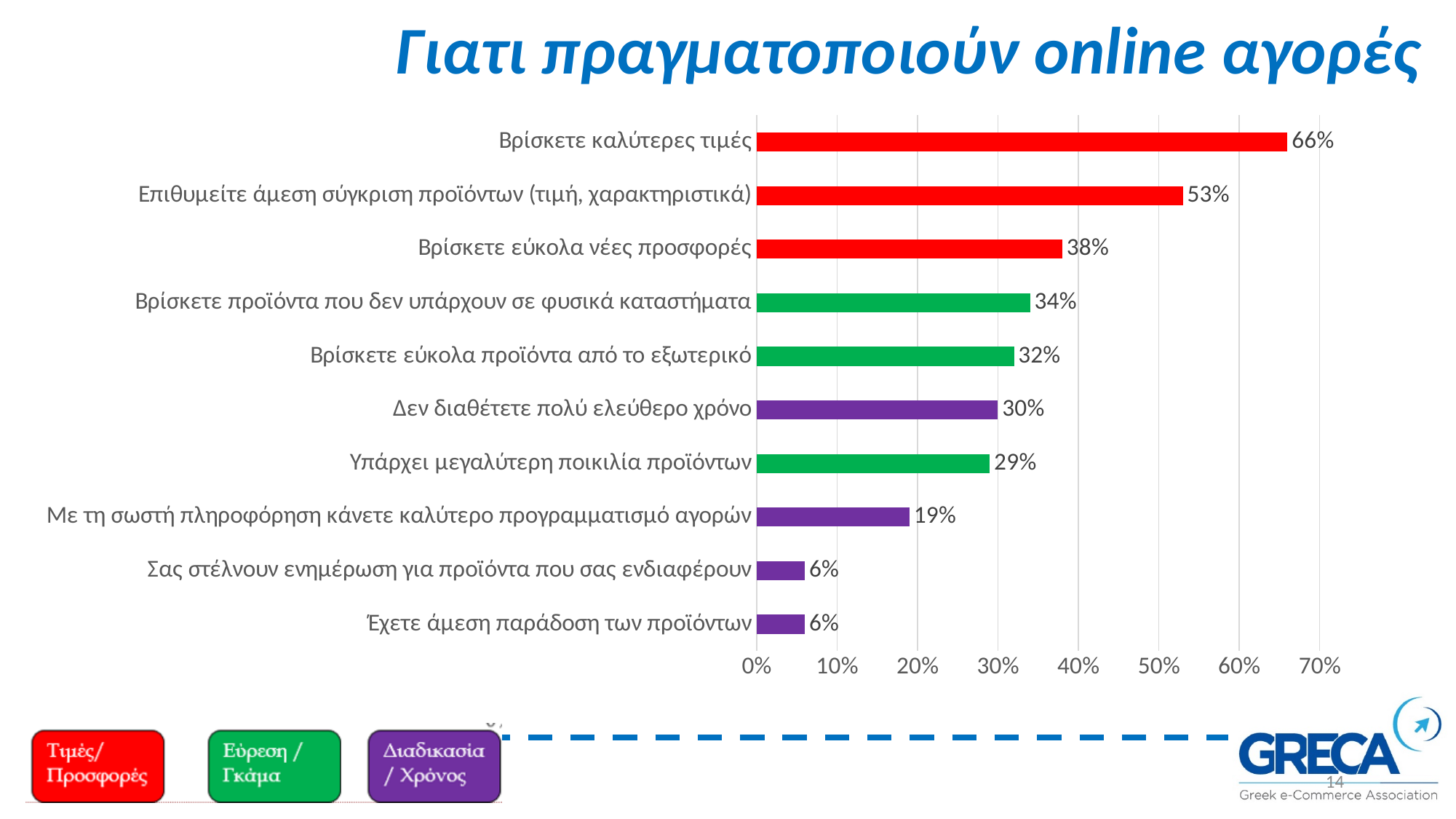
What is the difference between "Βρίσκετε εύκολα προϊόντα από το εξωτερικό" and "Υπάρχει μεγαλύτερη ποικιλία προϊόντων"? 3% What is the difference between "Βρίσκετε καλύτερες τιμές" and "Επιθυμείτε άμεση σύγκριση προϊόντων (τιμή, χαρακτηριστικά)"? 13% What colour are the bars for the "Τιμές/Προσφορές" group? red What is the value for "Δεν διαθέτετε πολύ ελεύθερο χρόνο"? 30% What percentage is shown for "Βρίσκετε καλύτερες τιμές"? 66% What kind of chart is shown on the slide? bar chart Which reason has the highest percentage? Βρίσκετε καλύτερες τιμές What percentage is shown for "Με τη σωστή πληροφόρηση κάνετε καλύτερο προγραμματισμό αγορών"? 19% Which is larger: "Βρίσκετε εύκολα νέες προσφορές" or "Βρίσκετε προϊόντα που δεν υπάρχουν σε φυσικά καταστήματα"? Βρίσκετε εύκολα νέες προσφορές Is the value for "Υπάρχει μεγαλύτερη ποικιλία προϊόντων" greater or less than 40%? less How many reasons (categories) are plotted in the chart? 10 What is the title of the slide? Γιατι πραγματοποιούν online αγορές